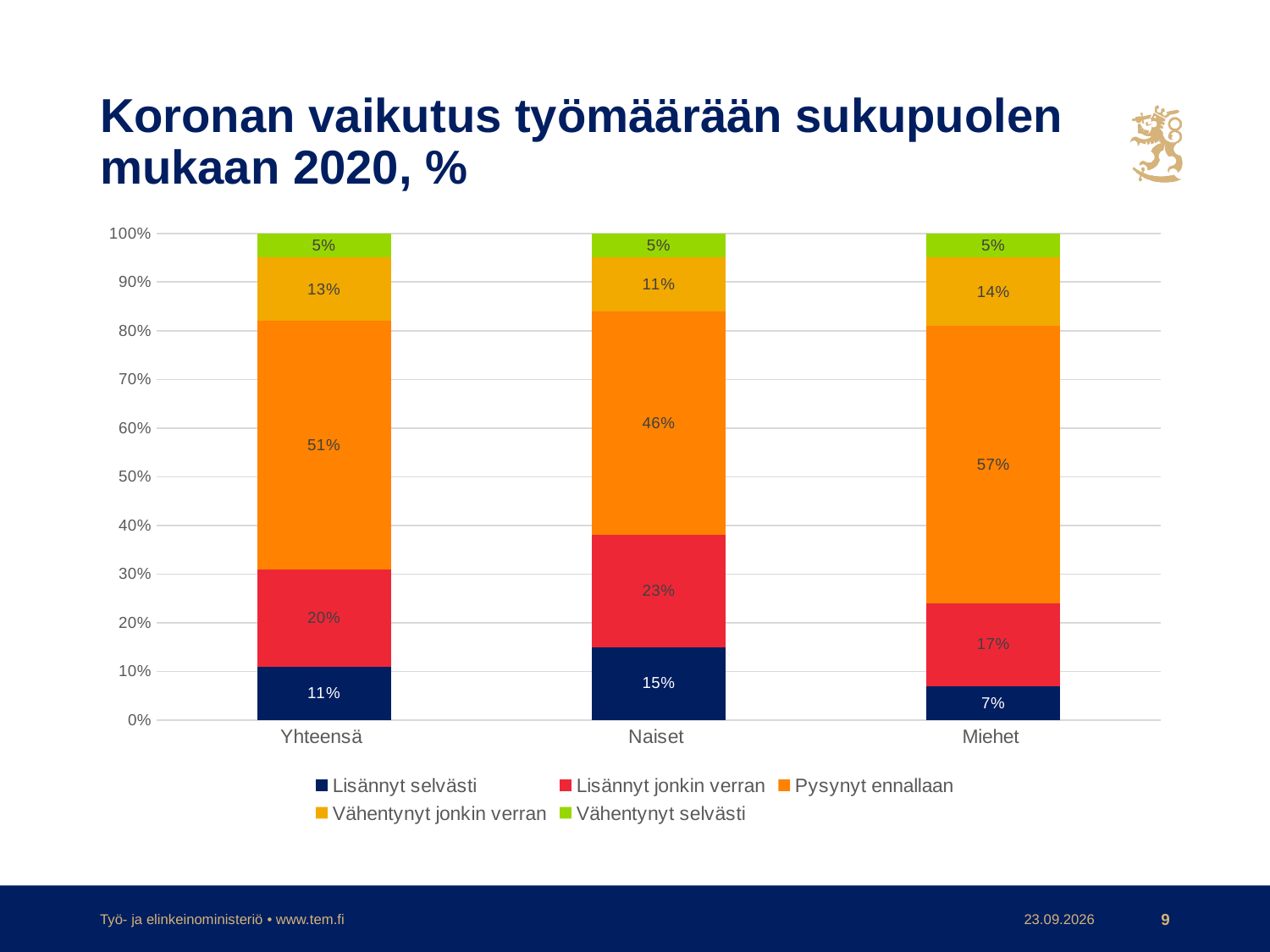
How many series does the legend list? 5 What is the value of "Vähentynyt jonkin verran" for Yhteensä? 13% What is the difference between the "Lisännyt jonkin verran" values for Naiset and Miehet? 6% Which category has the highest value for "Pysynyt ennallaan"? Miehet What is the value of "Pysynyt ennallaan" for Miehet? 57% What is the value of "Lisännyt selvästi" for Naiset? 15% What kind of chart is shown on the slide? Stacked bar chart Which series is shown in dark blue in the legend? Lisännyt selvästi What is the value of "Lisännyt jonkin verran" for Miehet? 17% How many categories are shown on the x axis? 3 Which category has the lowest value for "Lisännyt selvästi"? Miehet Which is larger: "Lisännyt selvästi" for Naiset or for Yhteensä? Naiset